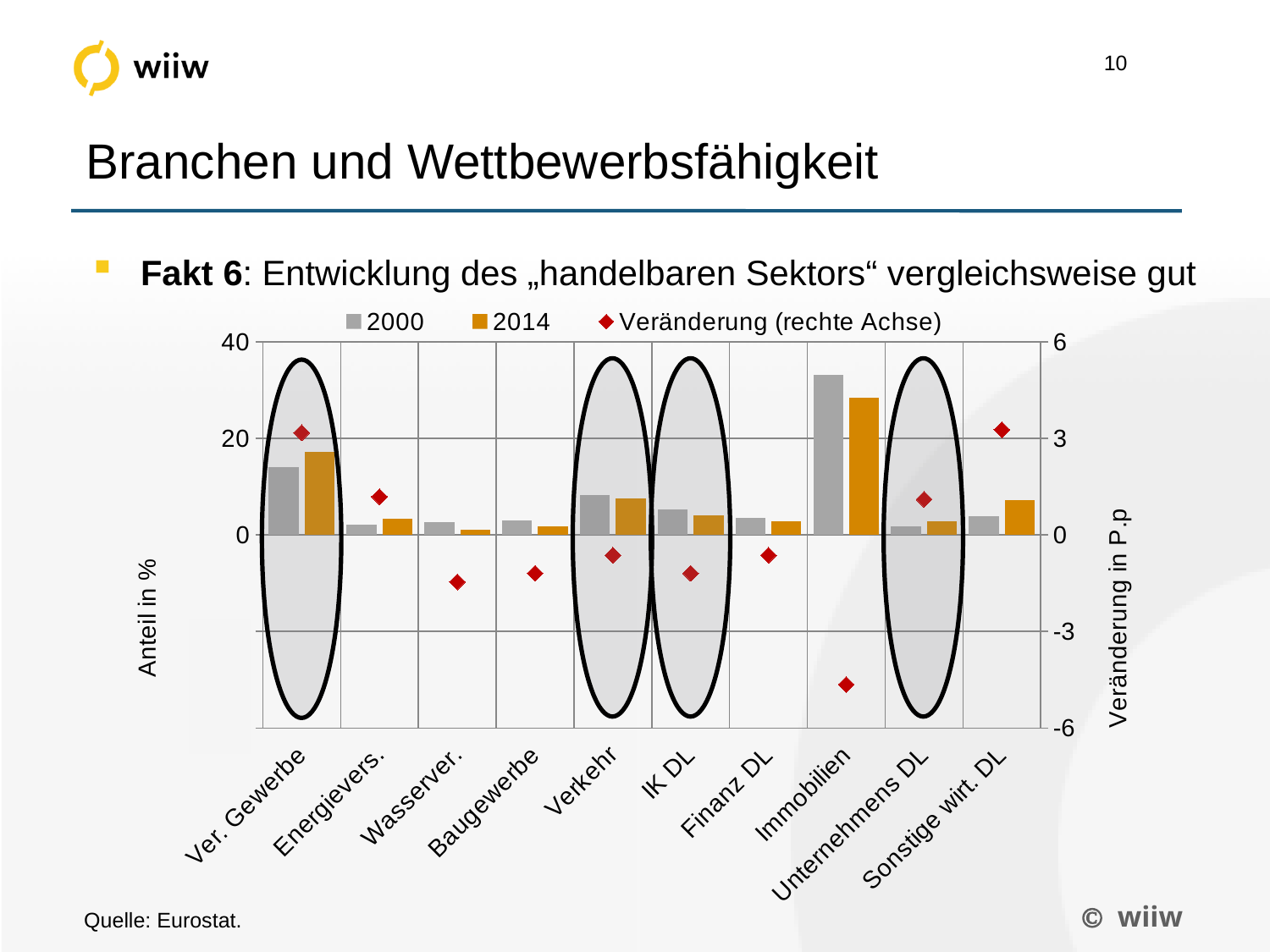
For Ver. Gewerbe, which is larger: the 2000 value or the 2014 value? 2014 How many categories are shown on the x axis of the chart? 10 For Immobilien, which is larger: the 2000 value or the 2014 value? 2000 Which category has the lowest value for the Veränderung (rechte Achse) series? Immobilien What kind of chart is shown on the slide? Bar chart (with a marker series on the right axis) Which category has the highest value for the 2000 series? Immobilien Is the Veränderung value for Immobilien greater or less than -3? less Is the 2000 value for Immobilien greater or less than 20? greater Is the 2014 value for Ver. Gewerbe greater or less than 20? less Which category has the highest value for the 2014 series? Immobilien How many series does the chart legend list? 3 What is the title of the right-hand vertical axis of the chart? Veränderung in P.p